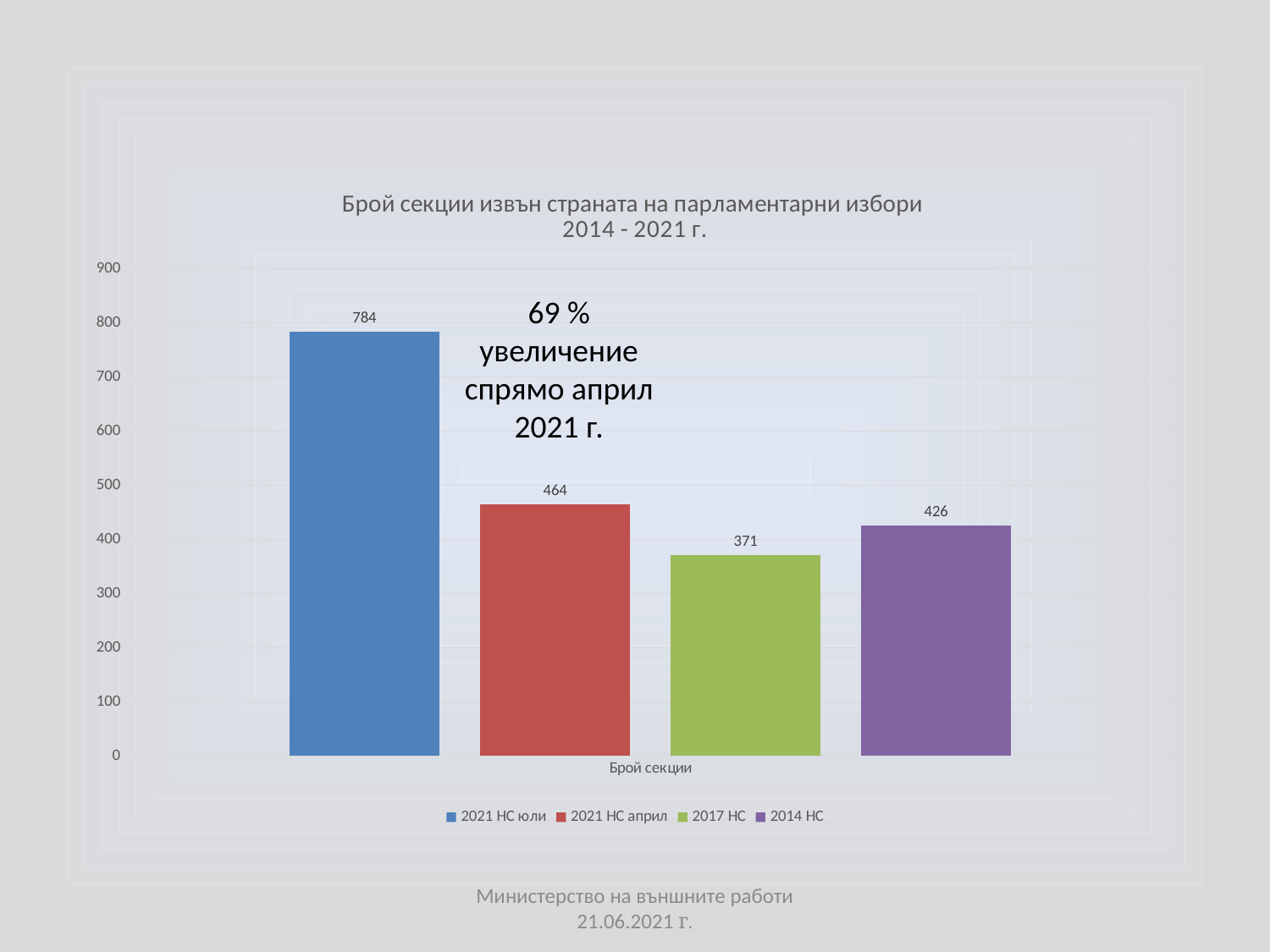
What is the value for 2014 НС? 426 Which series has the lowest value? 2017 НС Which series has the highest value? 2021 НС юли What is the title of the chart? Брой секции извън страната на парламентарни избори 2014 - 2021 г. What is the difference between the values for 2021 НС юли and 2021 НС април? 320 Which is larger, the value for 2014 НС or the value for 2021 НС април? 2021 НС април What kind of chart is shown on the slide? bar chart What is the difference between the values for 2014 НС and 2017 НС? 55 What is the value for 2021 НС юли? 784 What is the value for 2017 НС? 371 How many series does the legend list? 4 What is the value for 2021 НС април? 464